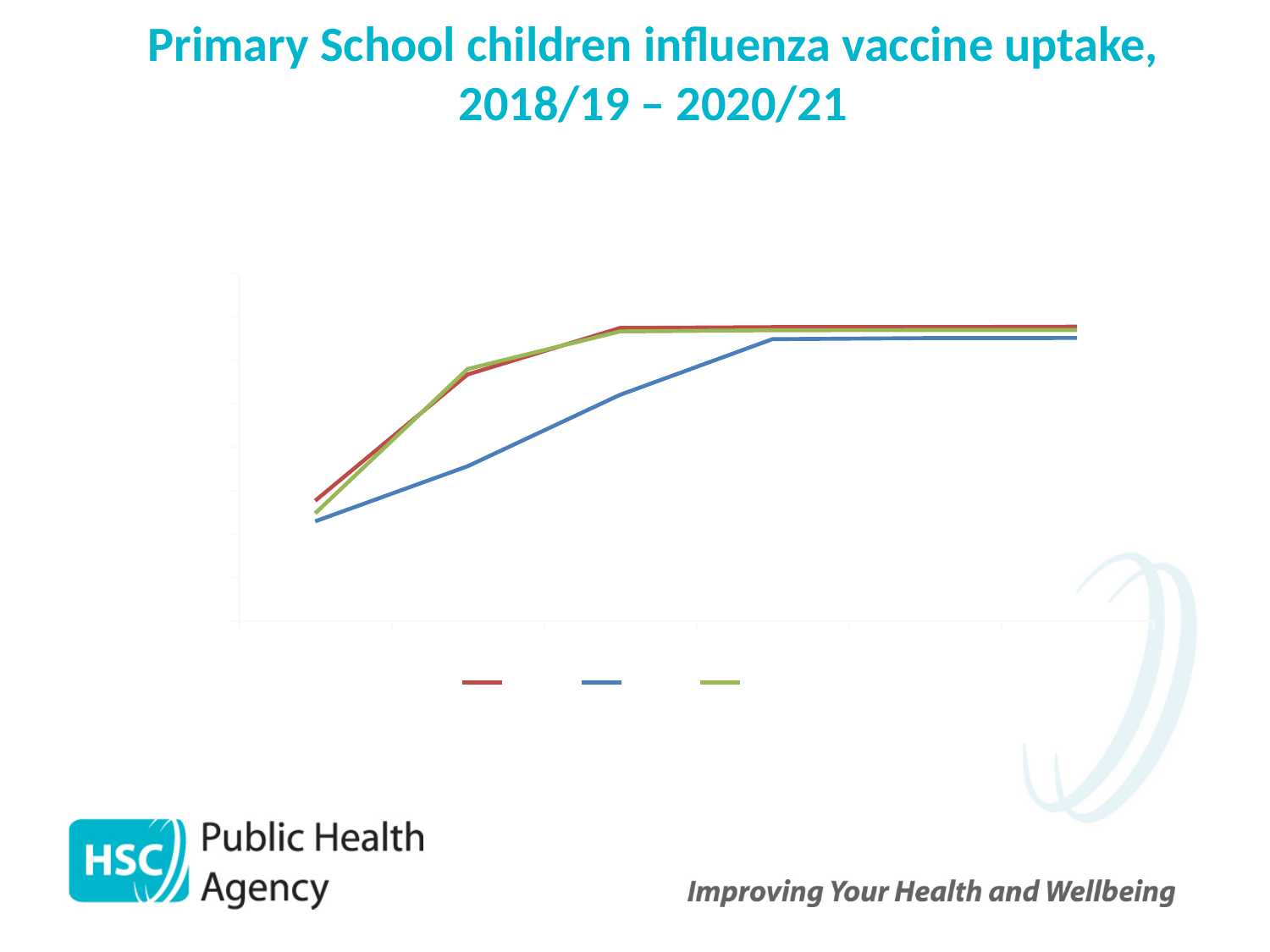
At the first point on the left, which is higher: the red line or the blue line? the red line What is the title of the slide containing the chart? Primary School children influenza vaccine uptake, 2018/19 – 2020/21 Do the lines keep rising steeply or level off towards the right-hand side of the chart? level off Do the plotted lines rise or fall from left to right along the x axis? rise What colours are the three lines in the chart? red, blue and green Which line is the lowest at the right-hand end of the chart? the blue line What kind of chart is shown on the slide? line chart Which line is the lowest at the first point on the left of the chart? the blue line How many series does the legend list? 3